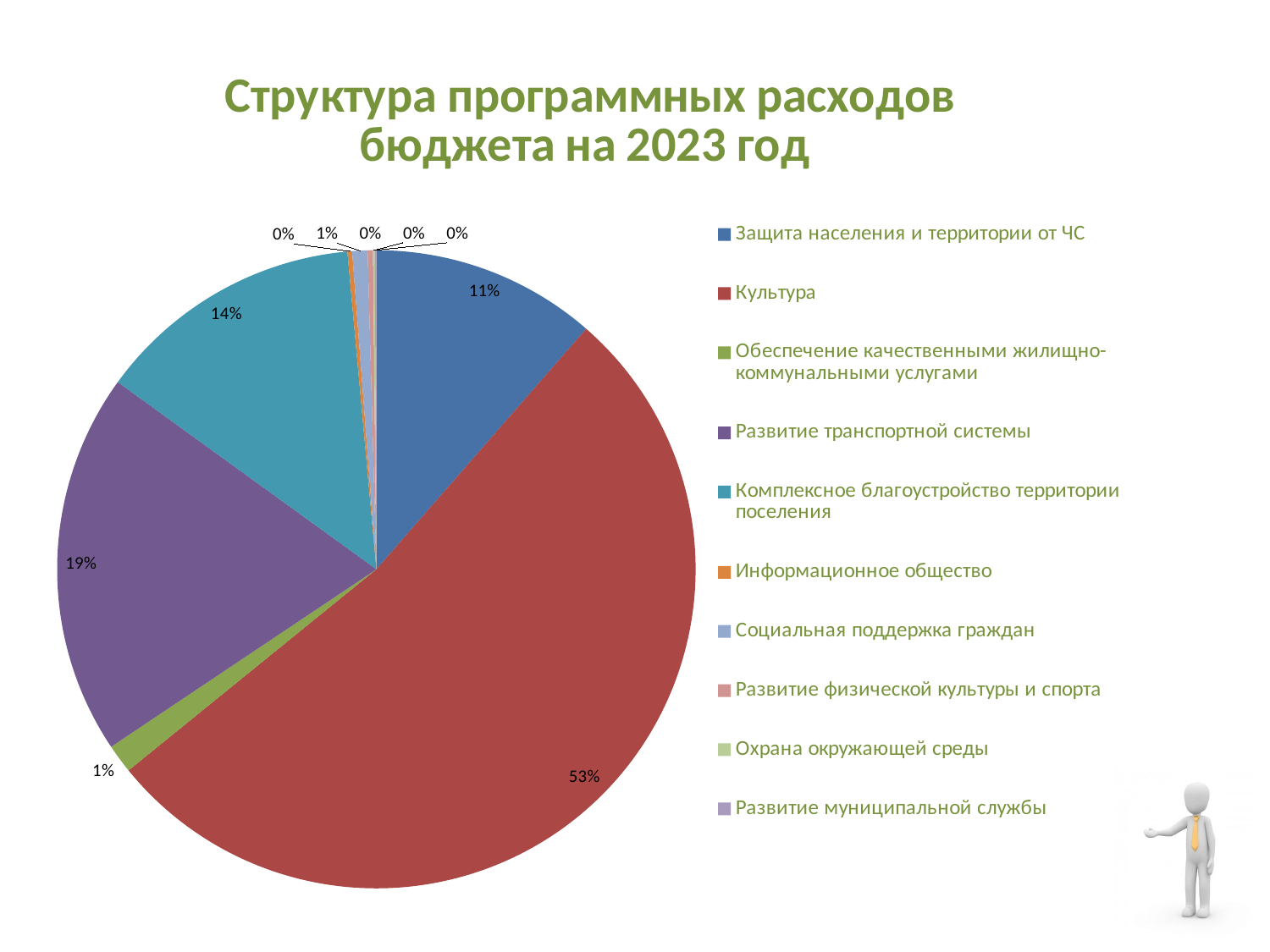
What is the title of the chart? Структура программных расходов бюджета на 2023 год What kind of chart is shown on the slide? pie chart What is the value shown for Развитие транспортной системы? 19% What is the value shown for Защита населения и территории от ЧС? 11% How many categories does the legend list? 10 What share of the pie does Культура take? 53% What is the value shown for Комплексное благоустройство территории поселения? 14% What is the difference in percentage points between Культура and Развитие транспортной системы? 34 Which is larger: Развитие транспортной системы or Комплексное благоустройство территории поселения? Развитие транспортной системы What is the value shown for Обеспечение качественными жилищно-коммунальными услугами? 1% Which category has the largest share of the pie? Культура What is the difference in percentage points between Развитие транспортной системы and Защита населения и территории от ЧС? 8